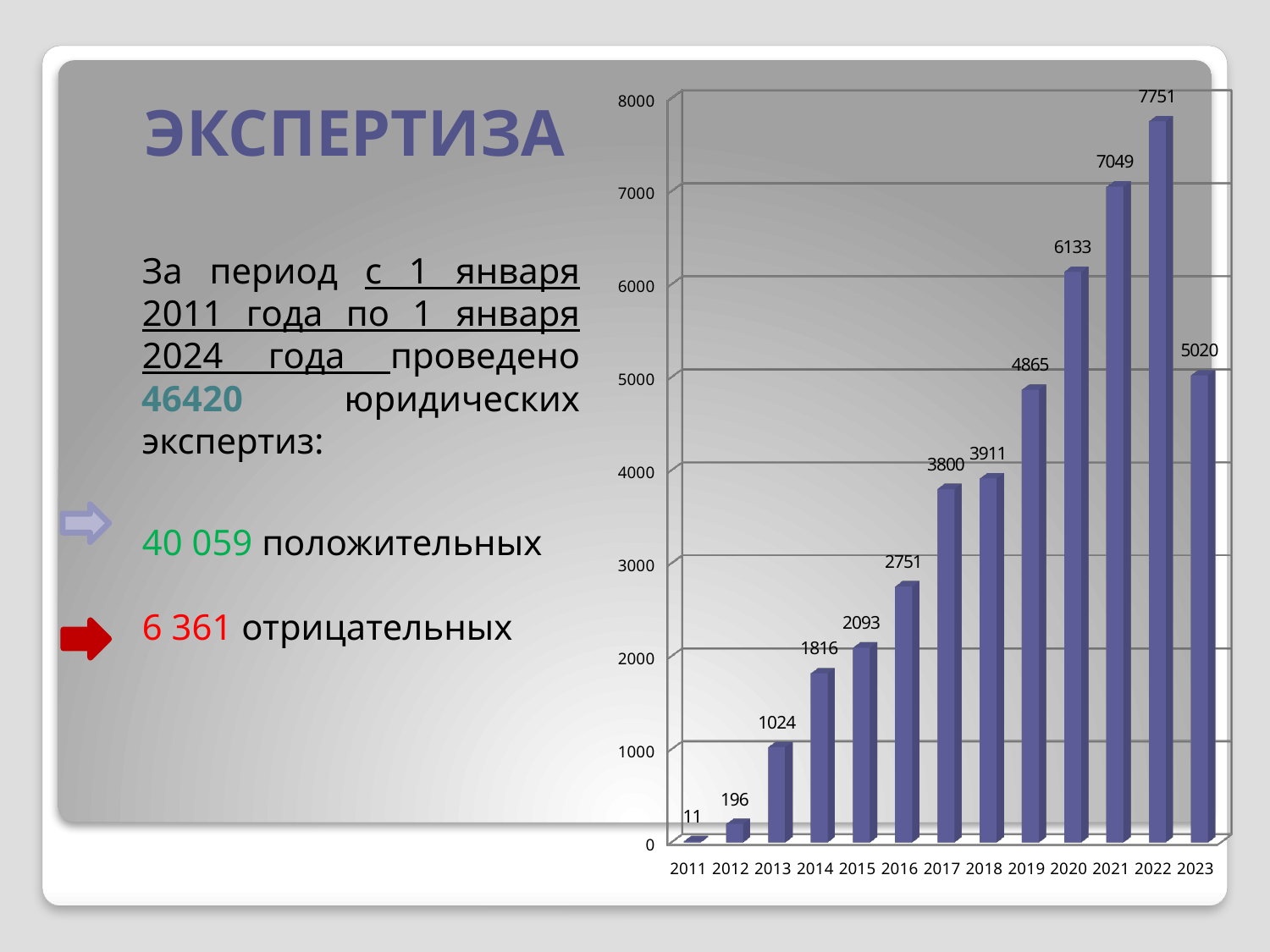
What is the value for 2019? 4865 Which year has the highest value? 2022 What is the difference between the values for 2022 and 2021? 702 Which year has the lowest value? 2011 What is the value for 2013? 1024 What is the difference between the values for 2018 and 2017? 111 Is the value for 2016 greater or less than 3000? less Which is larger, the value for 2020 or the value for 2023? 2020 Do the values rise or fall from 2011 to 2022? rise What kind of chart is shown? bar chart How many years are shown on the x axis? 13 What is the value for 2023? 5020